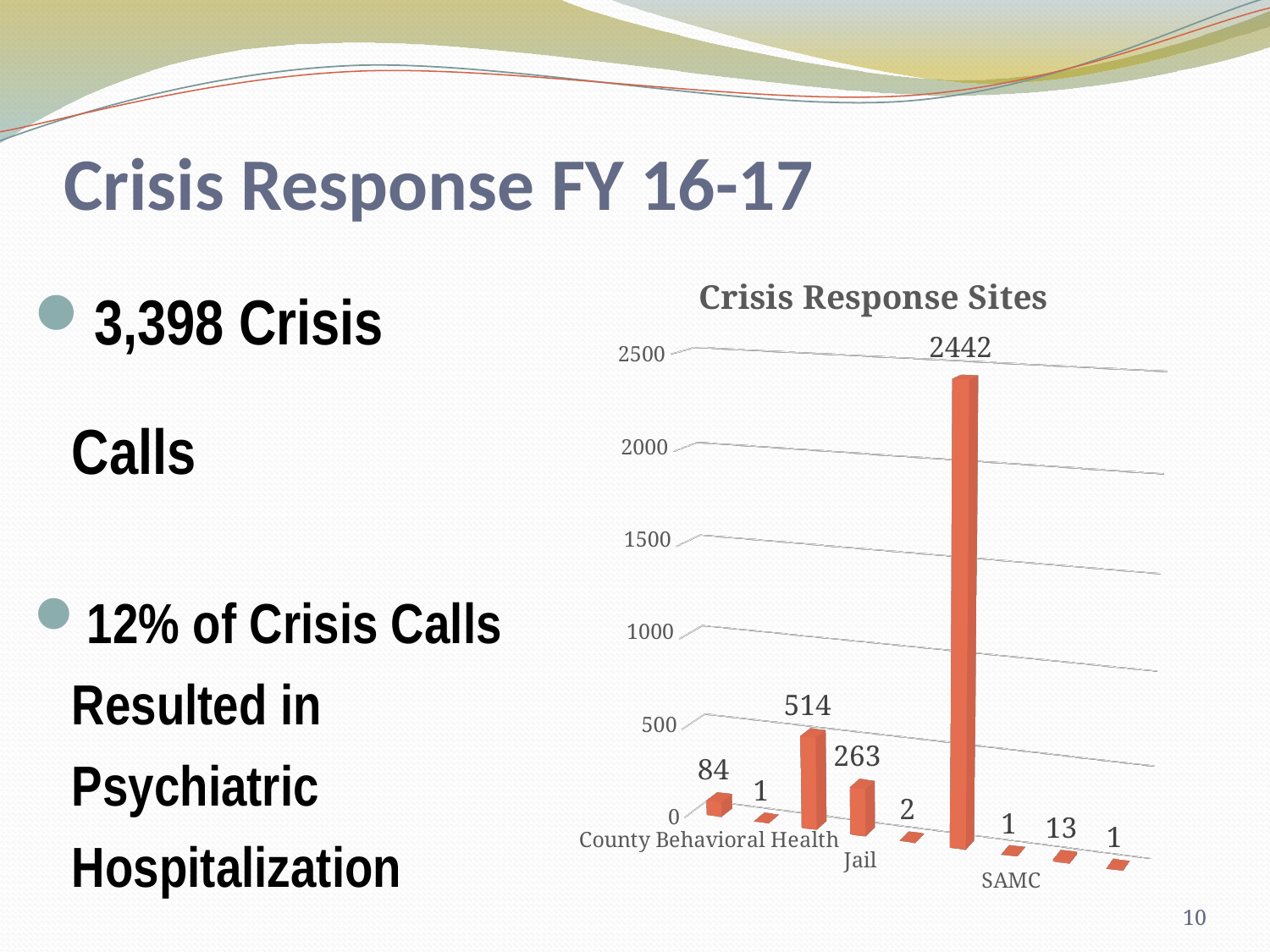
What is the value for Jail in the Crisis Response Sites chart? 263 What is the highest value shown in the Crisis Response Sites chart? 2442 What is the value for SAMC in the Crisis Response Sites chart? 1 What is the value for County Behavioral Health in the Crisis Response Sites chart? 84 What is the title of the chart on the slide? Crisis Response Sites What is the highest value labelled on the vertical axis of the Crisis Response Sites chart? 2500 What is the difference between the values for Jail and County Behavioral Health in the Crisis Response Sites chart? 179 Which is larger in the Crisis Response Sites chart, the value for County Behavioral Health or the value for SAMC? County Behavioral Health How many bars are plotted in the Crisis Response Sites chart? 9 Is the value for Jail in the Crisis Response Sites chart greater or less than 500? less Which is larger in the Crisis Response Sites chart, the value for Jail or the value for County Behavioral Health? Jail What kind of chart is shown on the slide? bar chart